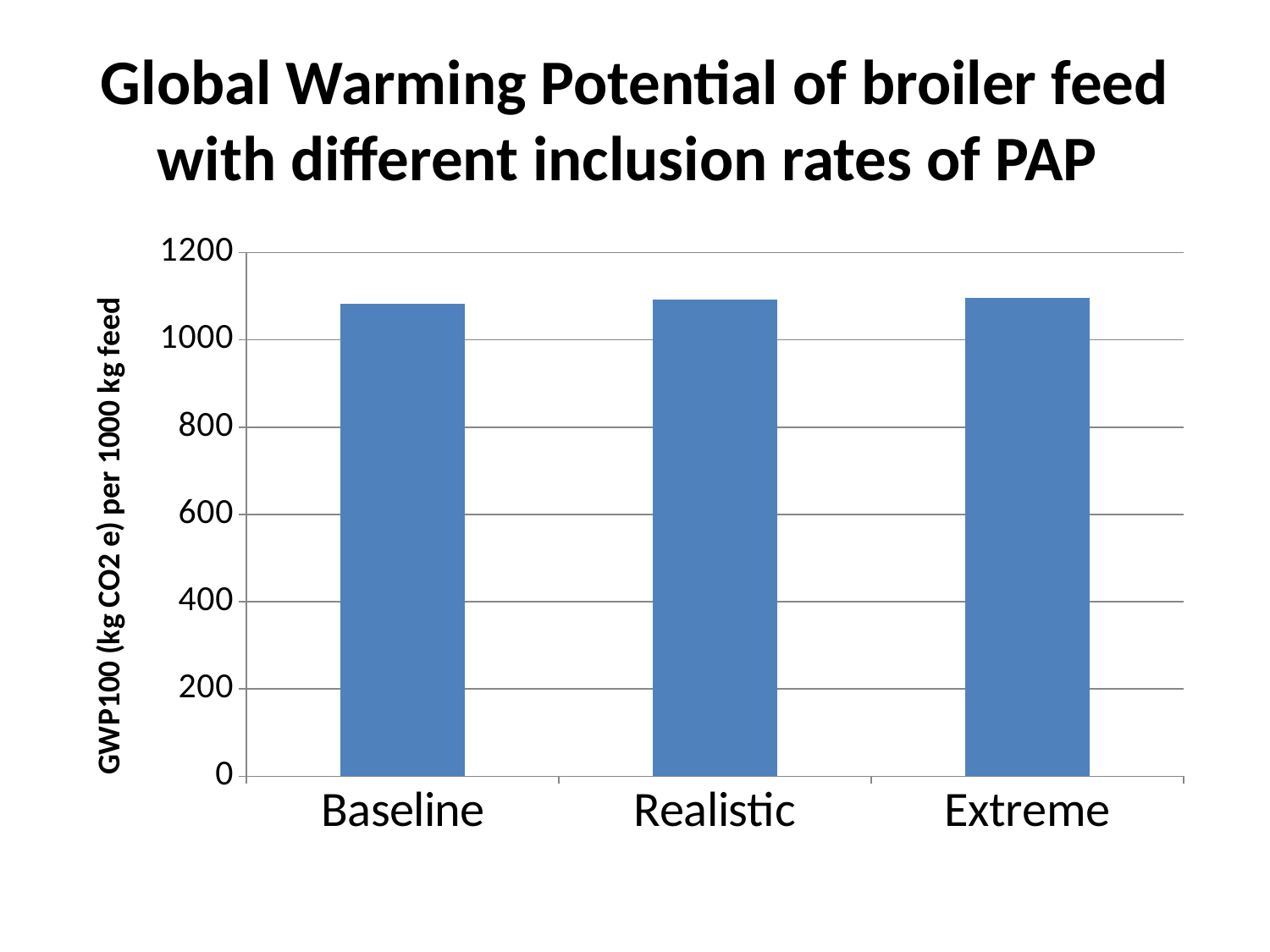
Is the value for Baseline greater or less than 1000? greater Which category is shown in the middle position on the x axis? Realistic How many categories are shown on the x axis of the chart? 3 Is the value for Baseline greater or less than 1200? less What is the highest tick value shown on the vertical axis? 1200 Is the value for Realistic greater or less than 1000? greater What is the label on the vertical axis of the chart? GWP100 (kg CO2 e) per 1000 kg feed What kind of chart is shown on the slide? bar chart What is the title of the chart? Global Warming Potential of broiler feed with different inclusion rates of PAP